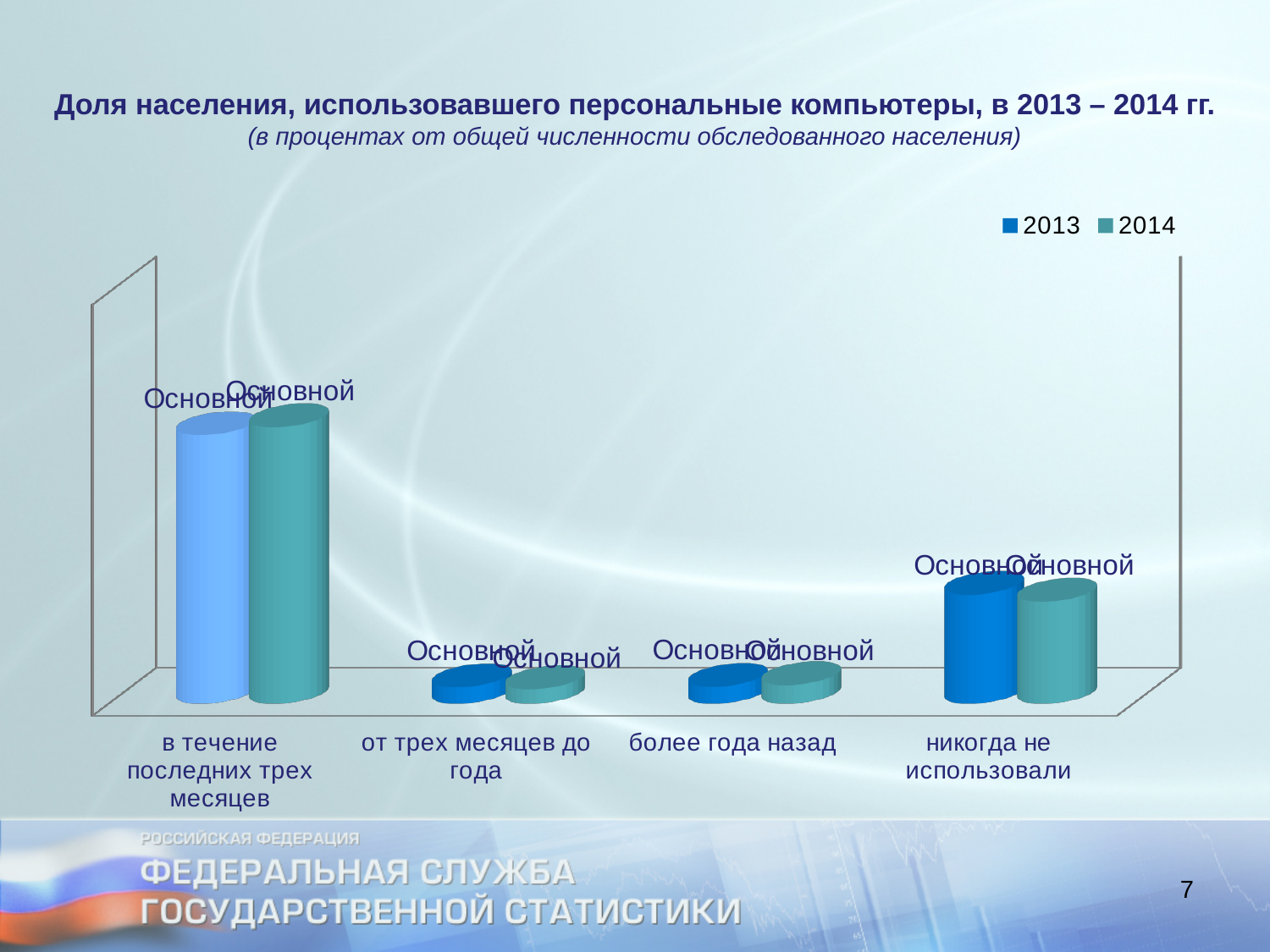
What are the two series listed in the chart legend? 2013 and 2014 How many series does the chart legend list? 2 Which category has the second-highest value for 2014? никогда не использовали For 2013, which is larger: the value for 'никогда не использовали' or for 'от трех месяцев до года'? никогда не использовали Which category has the highest value for 2014? в течение последних трех месяцев How many categories are shown along the x axis of the chart? 4 What is the title of the chart on the slide? Доля населения, использовавшего персональные компьютеры, в 2013 – 2014 гг. Which category has the highest value for 2013? в течение последних трех месяцев What kind of chart is shown on the slide? bar chart For 2014, which is larger: the value for 'никогда не использовали' or for 'более года назад'? никогда не использовали For 2013, which is larger: the value for 'в течение последних трех месяцев' or for 'никогда не использовали'? в течение последних трех месяцев